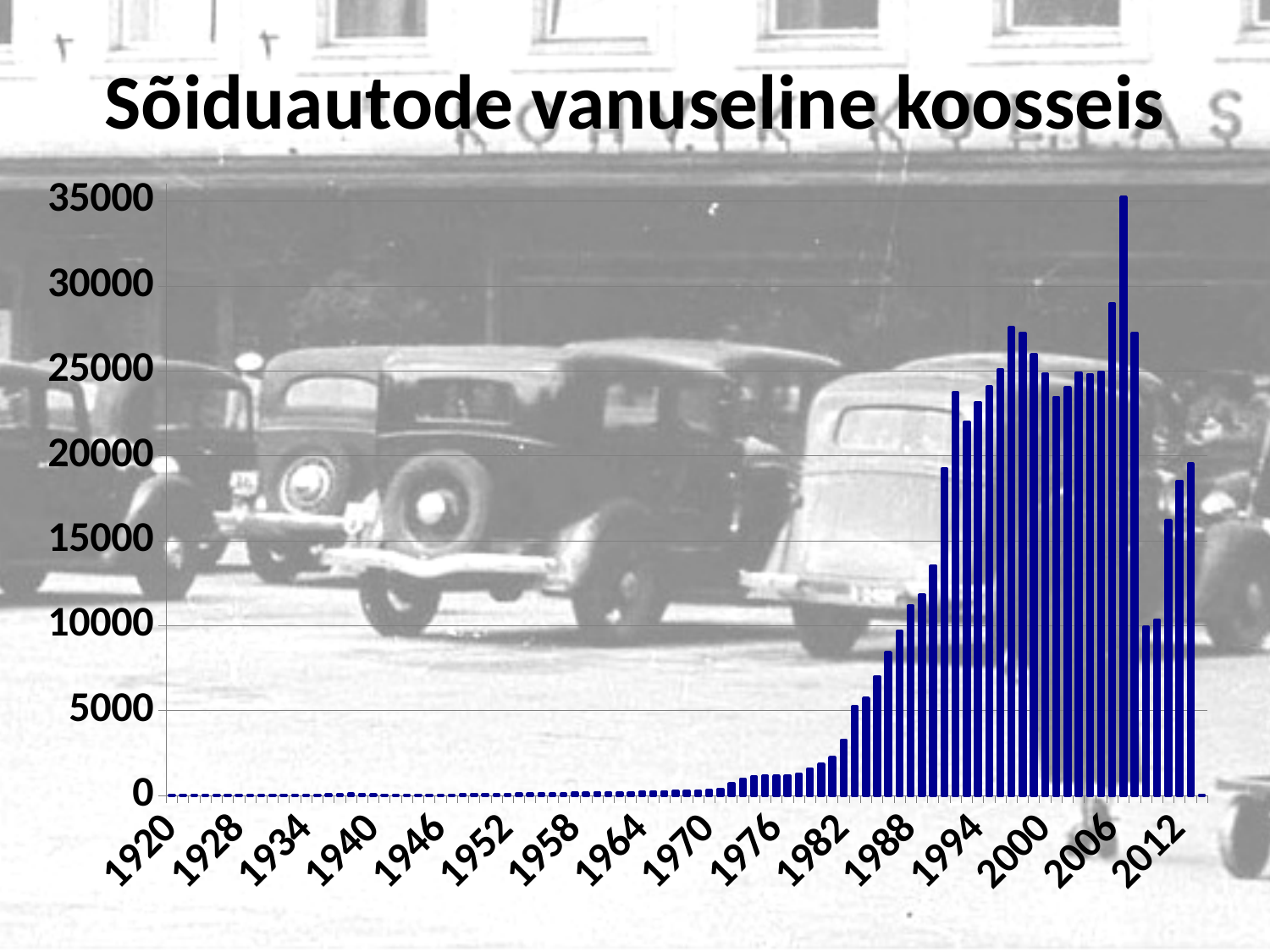
Is the value for 2000 greater or less than 20000? greater What is the highest value shown on the vertical axis? 35000 Is the value for 1976 greater or less than 5000? less Is the tallest bar in the chart greater or less than 30000? greater Do the values generally rise or fall along the x axis from 1920 to 1994? rise What is the title of the chart? Sõiduautode vanuseline koosseis What kind of chart is shown on the slide? bar chart Which year has the larger value, 1958 or 2000? 2000